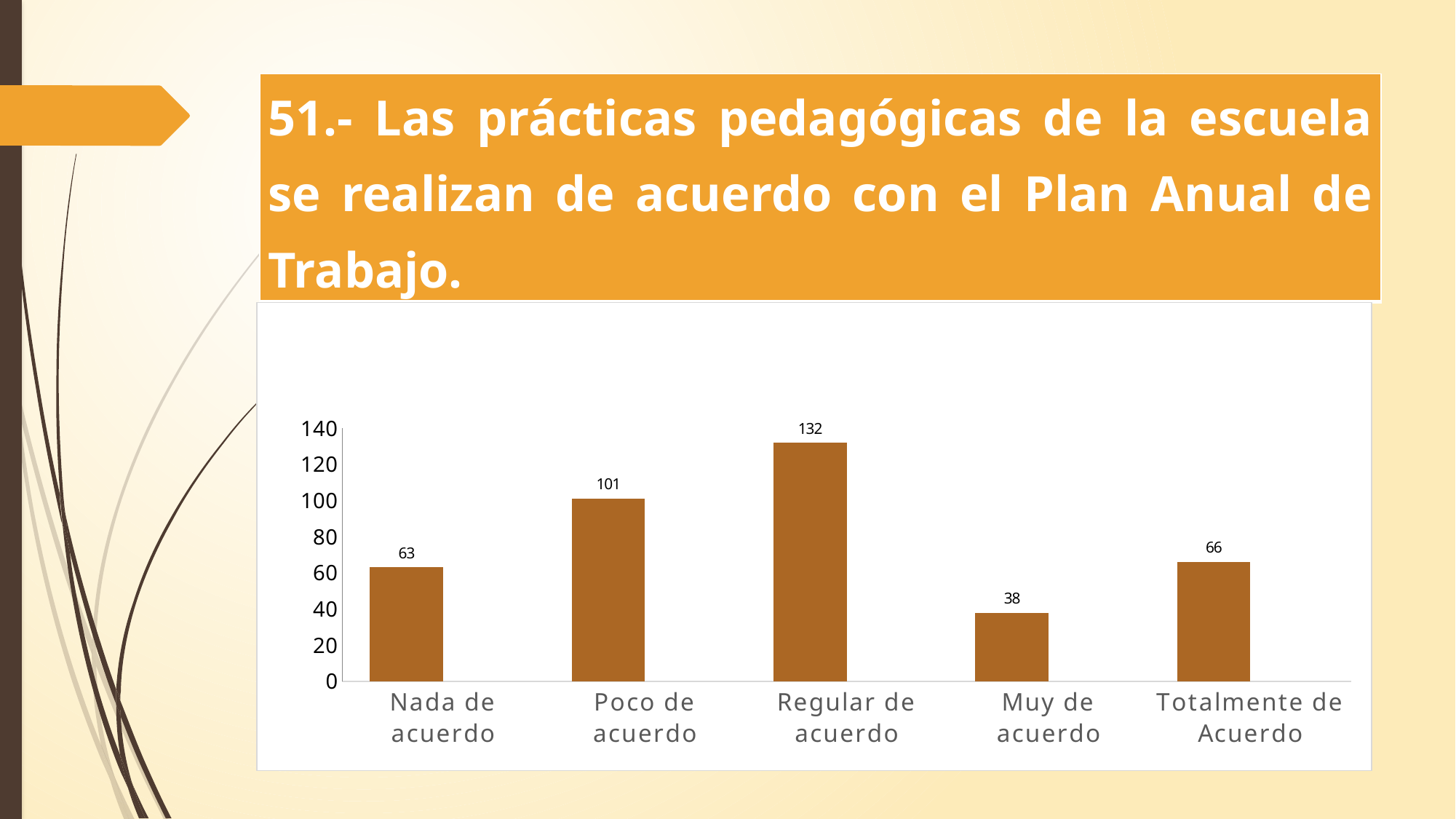
Which is larger, the value for "Poco de acuerdo" or the value for "Totalmente de Acuerdo"? Poco de acuerdo What is the highest value shown on the vertical axis? 140 What is the value for "Totalmente de Acuerdo"? 66 How many categories are shown on the x axis? 5 What is the difference between the values for "Totalmente de Acuerdo" and "Nada de acuerdo"? 3 What is the value for "Muy de acuerdo"? 38 Which category has the highest value? Regular de acuerdo What kind of chart is shown on the slide? bar chart Which category has the lowest value? Muy de acuerdo Is the value for "Nada de acuerdo" greater or less than 80? less What is the value for "Regular de acuerdo"? 132 What is the difference between the values for "Regular de acuerdo" and "Poco de acuerdo"? 31